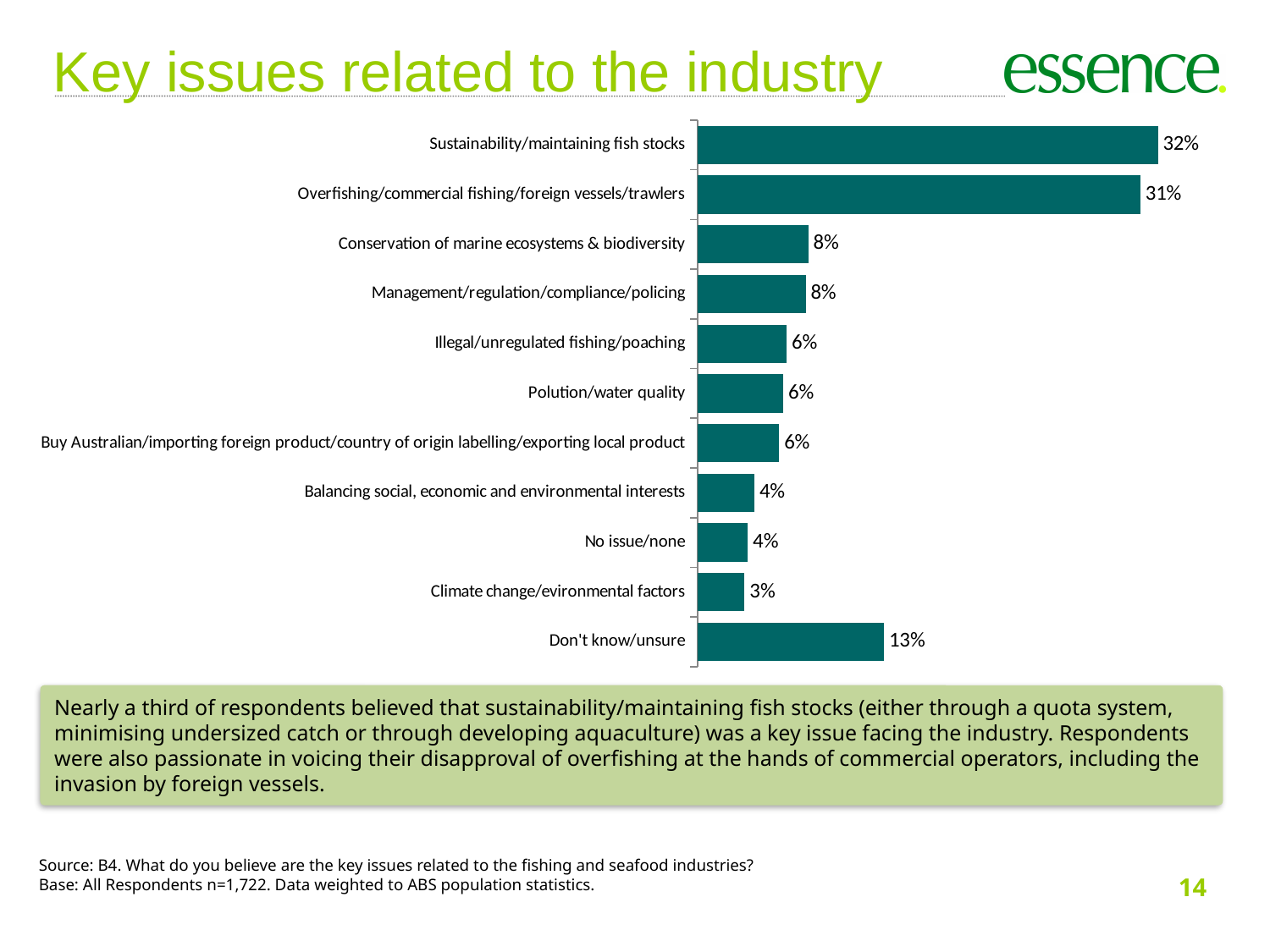
What is the value for Don't know/unsure? 13% What is the title of the slide containing the chart? Key issues related to the industry Which category has the highest value? Sustainability/maintaining fish stocks What percentage is shown for Climate change/evironmental factors? 3% What is the difference between Sustainability/maintaining fish stocks and Don't know/unsure? 19% How many categories are shown in the chart? 11 What kind of chart is shown on the slide? Bar chart Which category has the lowest value? Climate change/evironmental factors What is the difference between Conservation of marine ecosystems & biodiversity and Climate change/evironmental factors? 5% What percentage of respondents cited Sustainability/maintaining fish stocks as a key issue? 32% Which is larger: Don't know/unsure or Management/regulation/compliance/policing? Don't know/unsure What is the value for Overfishing/commercial fishing/foreign vessels/trawlers? 31%